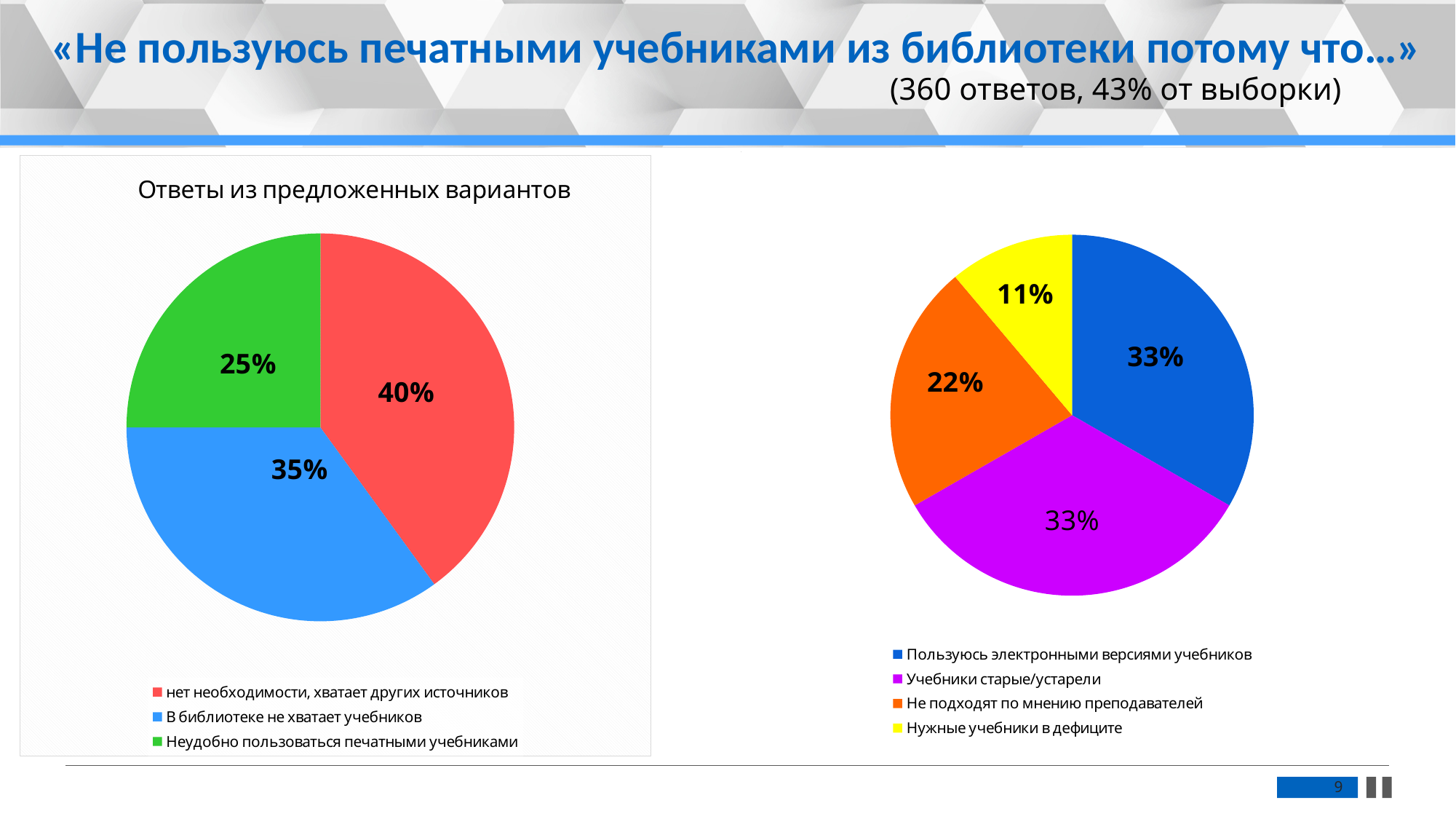
In the chart titled «Ответы из предложенных вариантов», what is the difference in percentage points between «нет необходимости, хватает других источников» and «Неудобно пользоваться печатными учебниками»? 15 percentage points How many categories does the chart titled «Ответы из предложенных вариантов» show? 3 In the right-hand pie chart, what share is «Не подходят по мнению преподавателей»? 22% In the right-hand pie chart, what share is «Нужные учебники в дефиците»? 11% In the chart titled «Ответы из предложенных вариантов», which category has the smallest share? Неудобно пользоваться печатными учебниками In the chart titled «Ответы из предложенных вариантов», which category has the largest share? нет необходимости, хватает других источников In the right-hand pie chart, which is larger: «Учебники старые/устарели» or «Не подходят по мнению преподавателей»? Учебники старые/устарели What type of chart is the chart titled «Ответы из предложенных вариантов»? Pie chart In the chart titled «Ответы из предложенных вариантов», what share of responses is «нет необходимости, хватает других источников»? 40% How many entries does the legend of the right-hand pie chart list? 4 In the right-hand pie chart, which category has the smallest share? Нужные учебники в дефиците